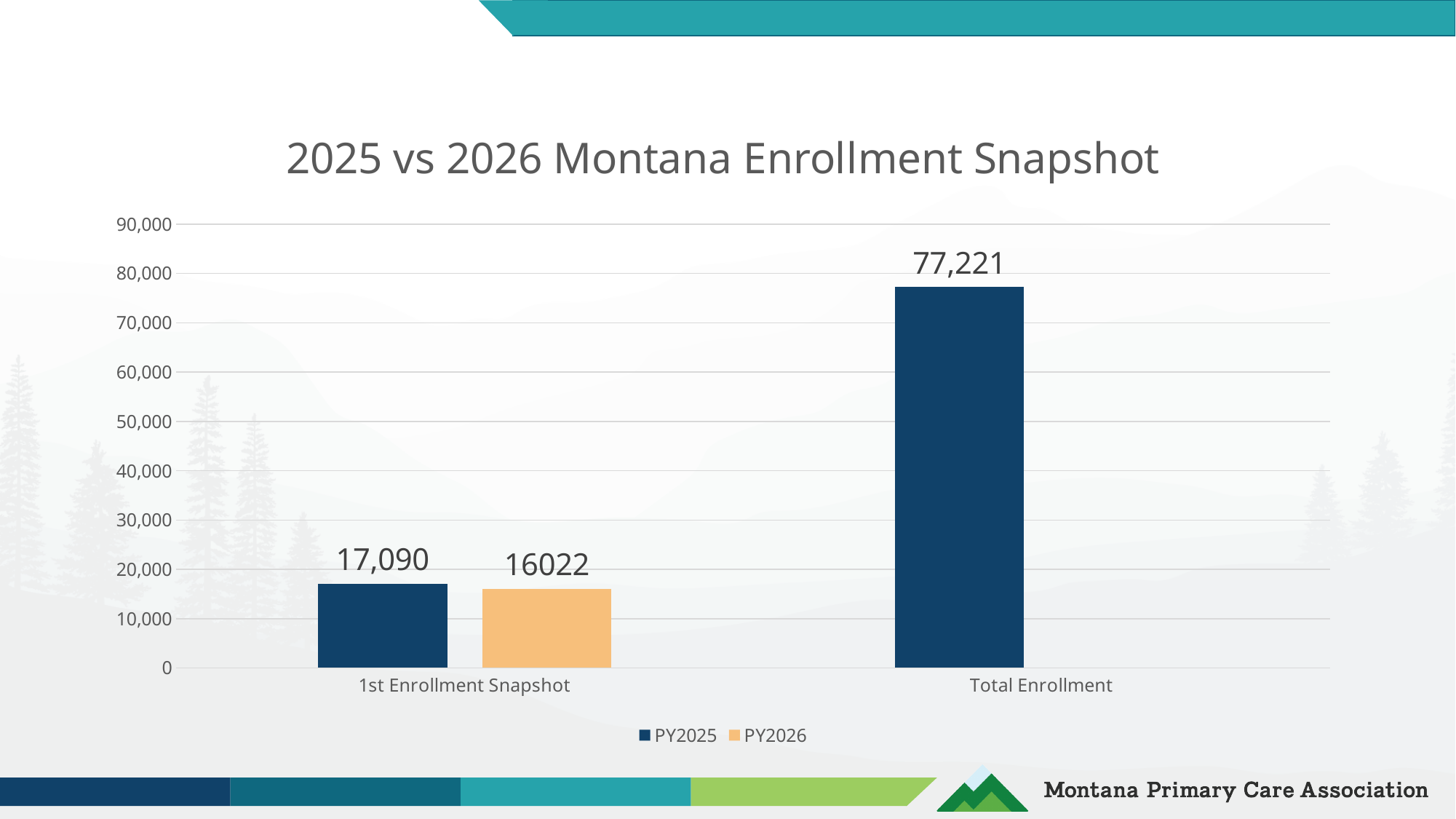
Which category has the highest PY2025 value? Total Enrollment What is the title of the chart? 2025 vs 2026 Montana Enrollment Snapshot For 1st Enrollment Snapshot, which series has the larger value, PY2025 or PY2026? PY2025 What is the PY2026 value for 1st Enrollment Snapshot? 16022 What is the PY2025 value for 1st Enrollment Snapshot? 17,090 What is the PY2025 value for Total Enrollment? 77,221 What is the difference between the PY2025 and PY2026 values for 1st Enrollment Snapshot? 1,068 How many series does the legend list? 2 Is the PY2025 value for Total Enrollment greater or less than 70,000? greater What kind of chart is shown on the slide? Bar chart How many categories are shown on the x axis? 2 Which category has the lowest PY2025 value? 1st Enrollment Snapshot